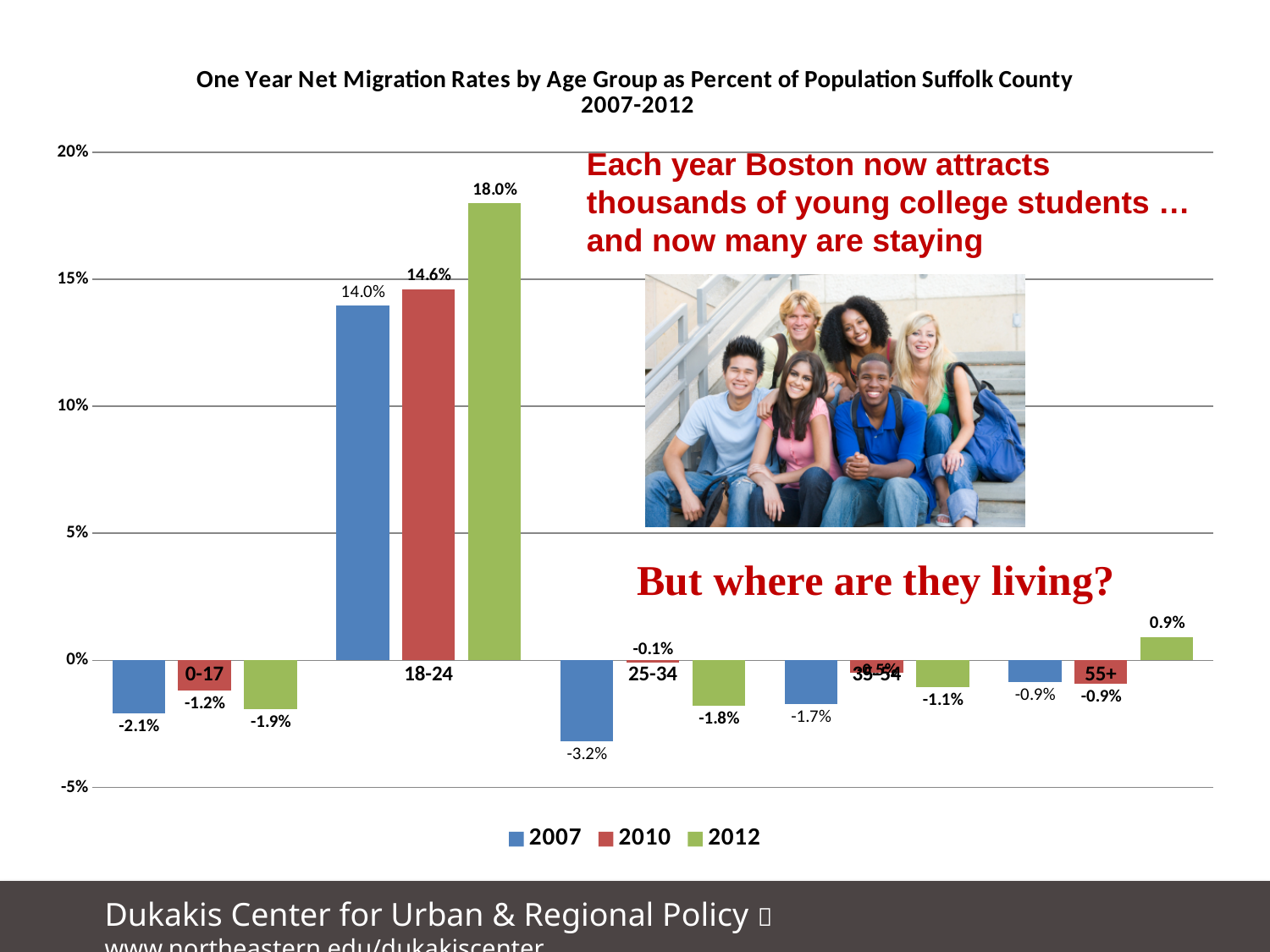
What is the 2012 net migration rate for the 55+ age group? 0.9% What is the 2007 net migration rate for the 25-34 age group? -3.2% What kind of chart is shown on the slide? Bar chart Which age group has the lowest net migration rate in 2007? 25-34 What is the 2012 net migration rate for the 18-24 age group? 18.0% Which age group has the highest net migration rate in 2012? 18-24 What is the 2010 net migration rate for the 0-17 age group? -1.2% Which is larger for the 0-17 age group, the 2007 value or the 2012 value? 2012 Is the 2010 value for the 18-24 age group greater or less than 15%? less What is the difference between the 2012 and 2007 net migration rates for the 18-24 age group? 4.0% How many series does the legend list? 3 How many age groups are shown on the x axis? 5